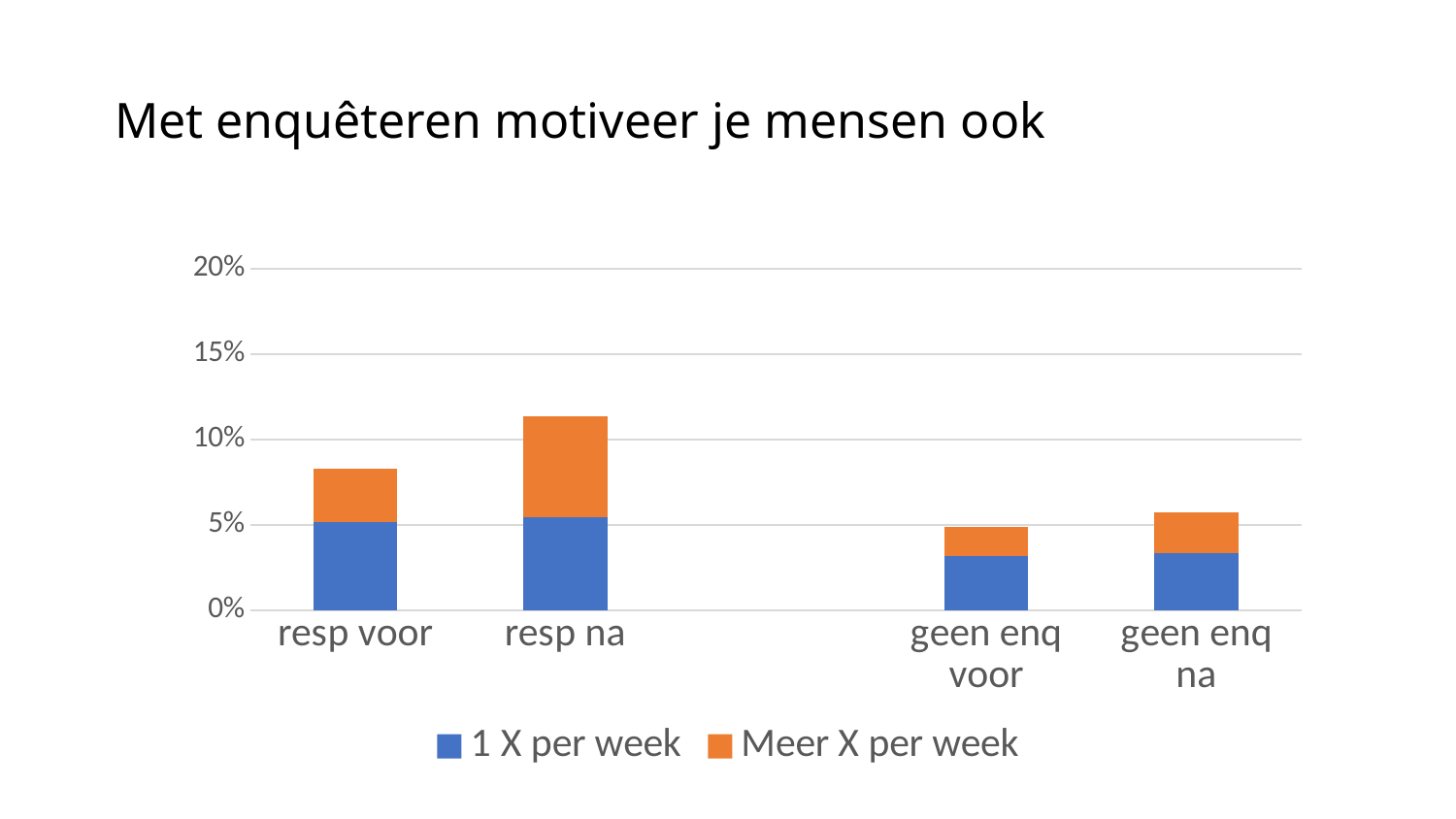
What kind of chart is shown on the slide? Stacked bar chart Is the total bar for resp voor greater or less than 10%? less Is the total bar for geen enq na greater or less than 5%? greater Is the '1 X per week' value for geen enq voor greater or less than 5%? less Which has the larger total bar, geen enq voor or geen enq na? geen enq na What is the title of the slide? Met enquêteren motiveer je mensen ook Which has the larger total bar, resp voor or resp na? resp na Which category has the lowest total bar? geen enq voor Which category has the highest total bar? resp na How many series does the legend list? 2 How many categories are shown on the x axis of the chart? 4